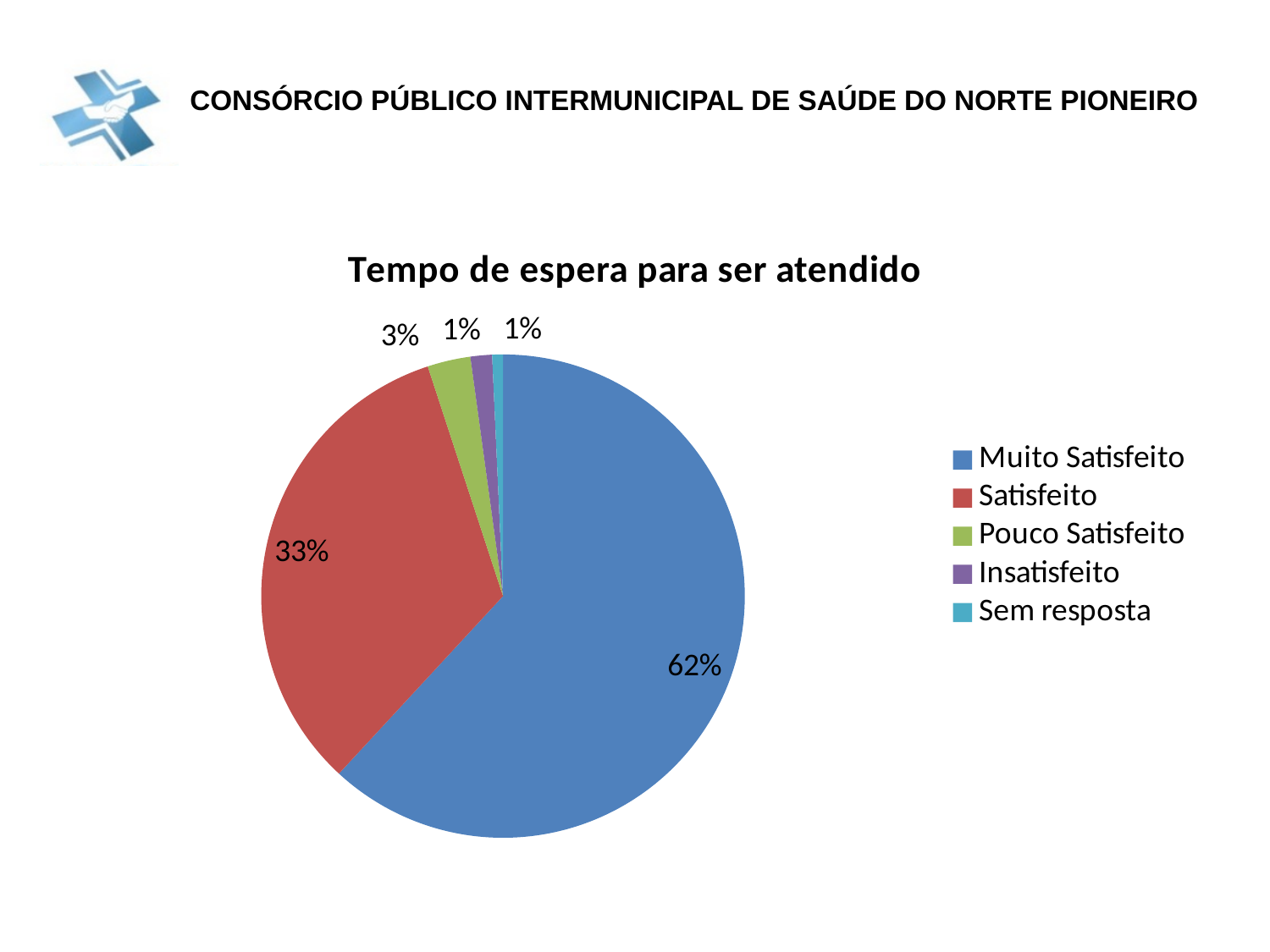
What share of the pie is Pouco Satisfeito? 3% What share of the pie is Insatisfeito? 1% What is the difference between the Muito Satisfeito and Satisfeito shares? 29% What is the combined share of Muito Satisfeito and Satisfeito? 95% What share of the pie is Satisfeito? 33% Which is larger, the Satisfeito slice or the Pouco Satisfeito slice? Satisfeito How many categories does the legend list? 5 What kind of chart is shown on the slide? pie chart Which colour represents Sem resposta in the legend? light blue What is the title of the chart? Tempo de espera para ser atendido Which category has the largest slice of the pie? Muito Satisfeito